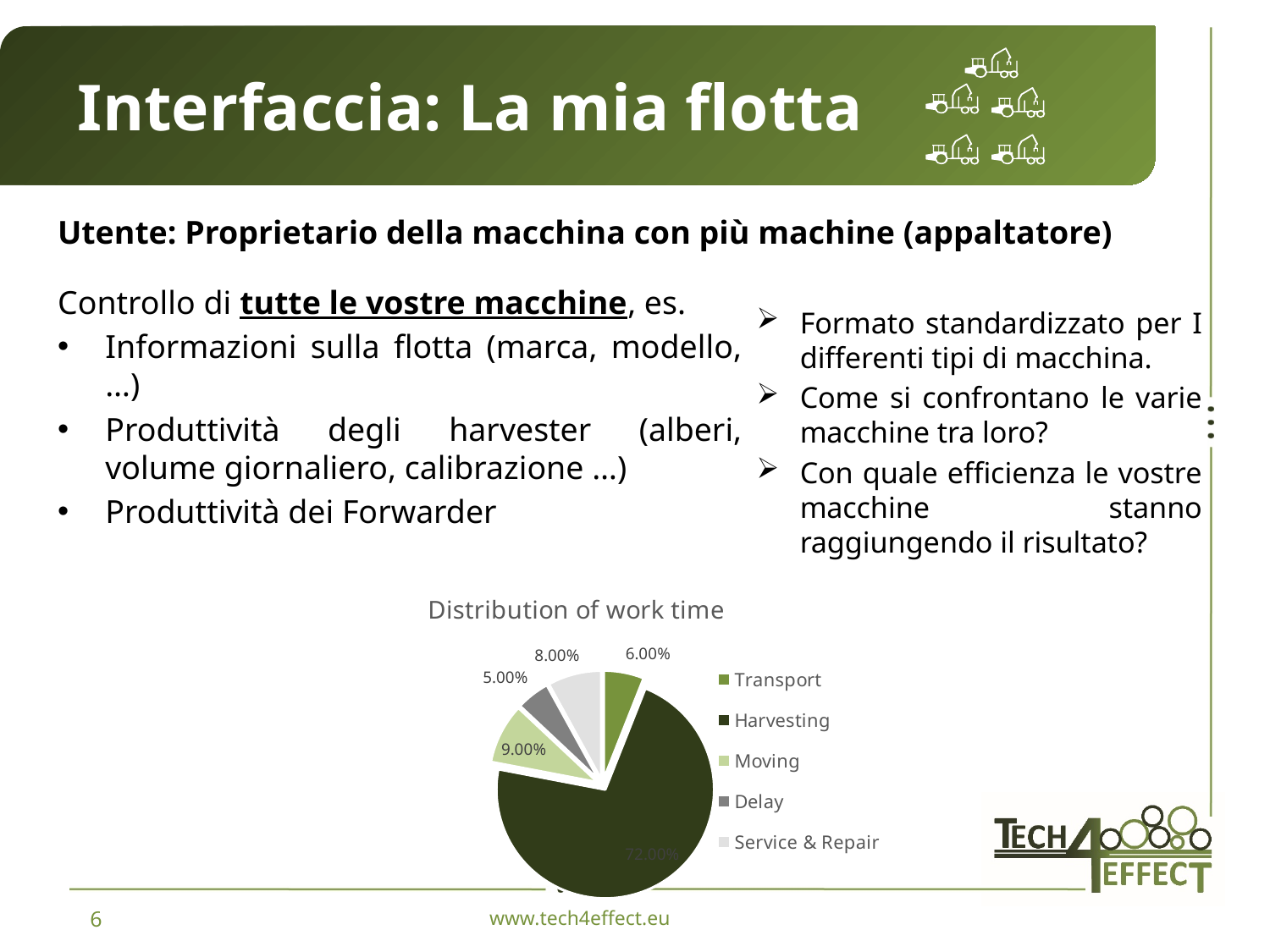
What kind of chart is shown on the slide? pie chart Which category has the smallest share of work time in the pie chart? Delay What share of work time does Harvesting account for in the pie chart? 72.00% What share of work time does Service & Repair account for in the pie chart? 8.00% How many categories does the legend of the pie chart list? 5 What share of work time does Moving account for in the pie chart? 9.00% What share of work time does Transport account for in the pie chart? 6.00% What is the title of the chart on the slide? Distribution of work time Which has a larger share of work time, Moving or Service & Repair? Moving What share of work time does Delay account for in the pie chart? 5.00% Which category has the largest share of work time in the pie chart? Harvesting What is the difference in percentage points between the Harvesting share and the Moving share? 63.00%